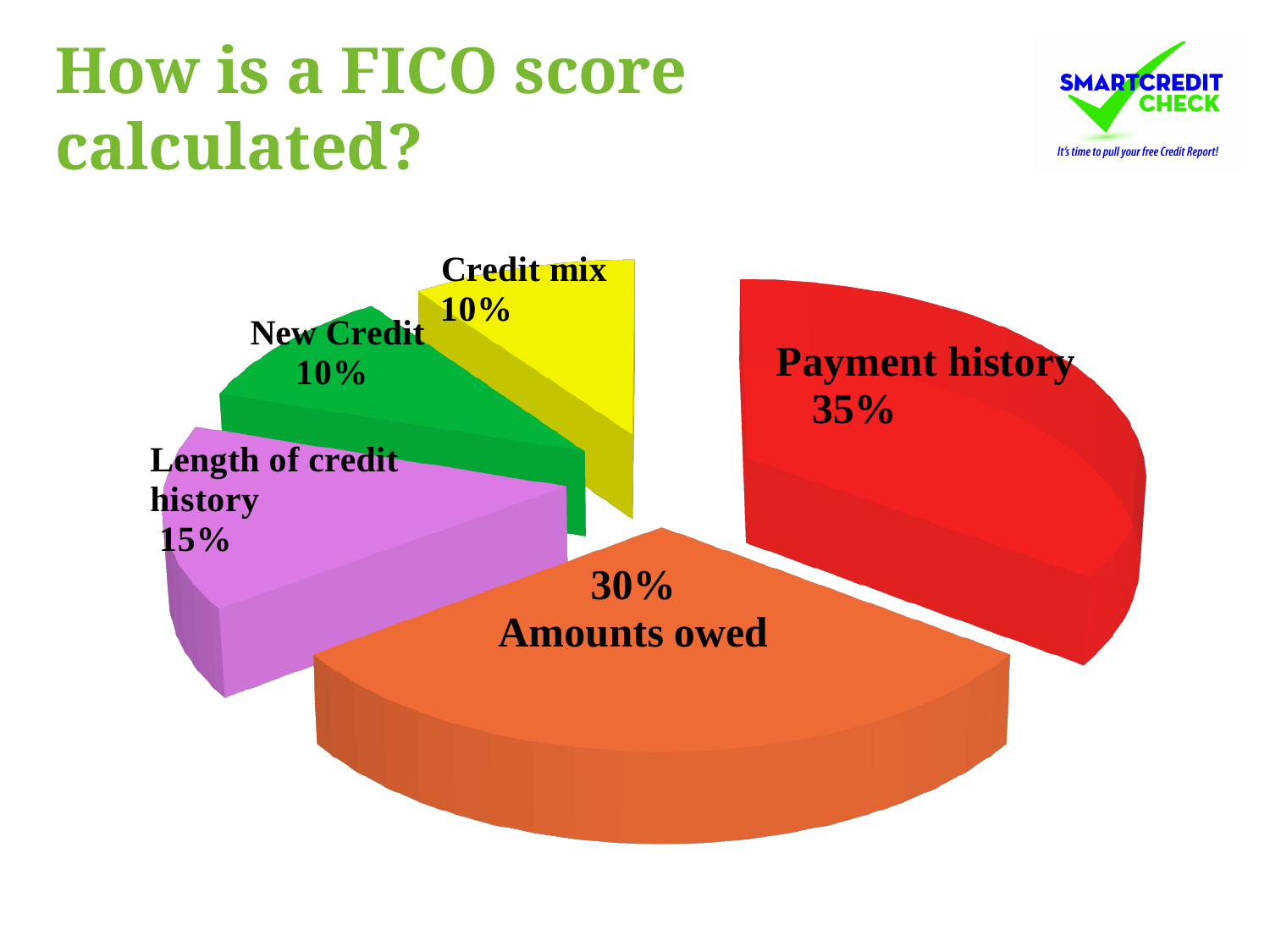
What colour is the Payment history slice? Red Which factor has the largest share of the FICO score? Payment history What is the difference between the shares for Payment history and Amounts owed? 5% How many factors (slices) are shown in the pie chart? 5 What is the title of the slide containing the chart? How is a FICO score calculated? Which has a larger share, Amounts owed or Length of credit history? Amounts owed What share of the FICO score does Length of credit history account for? 15% What share of the FICO score does Credit mix account for? 10% What share of the FICO score does Payment history account for? 35% What is the difference between the shares for Length of credit history and New Credit? 5% What kind of chart is shown on the slide? Pie chart What share of the FICO score does Amounts owed account for? 30%